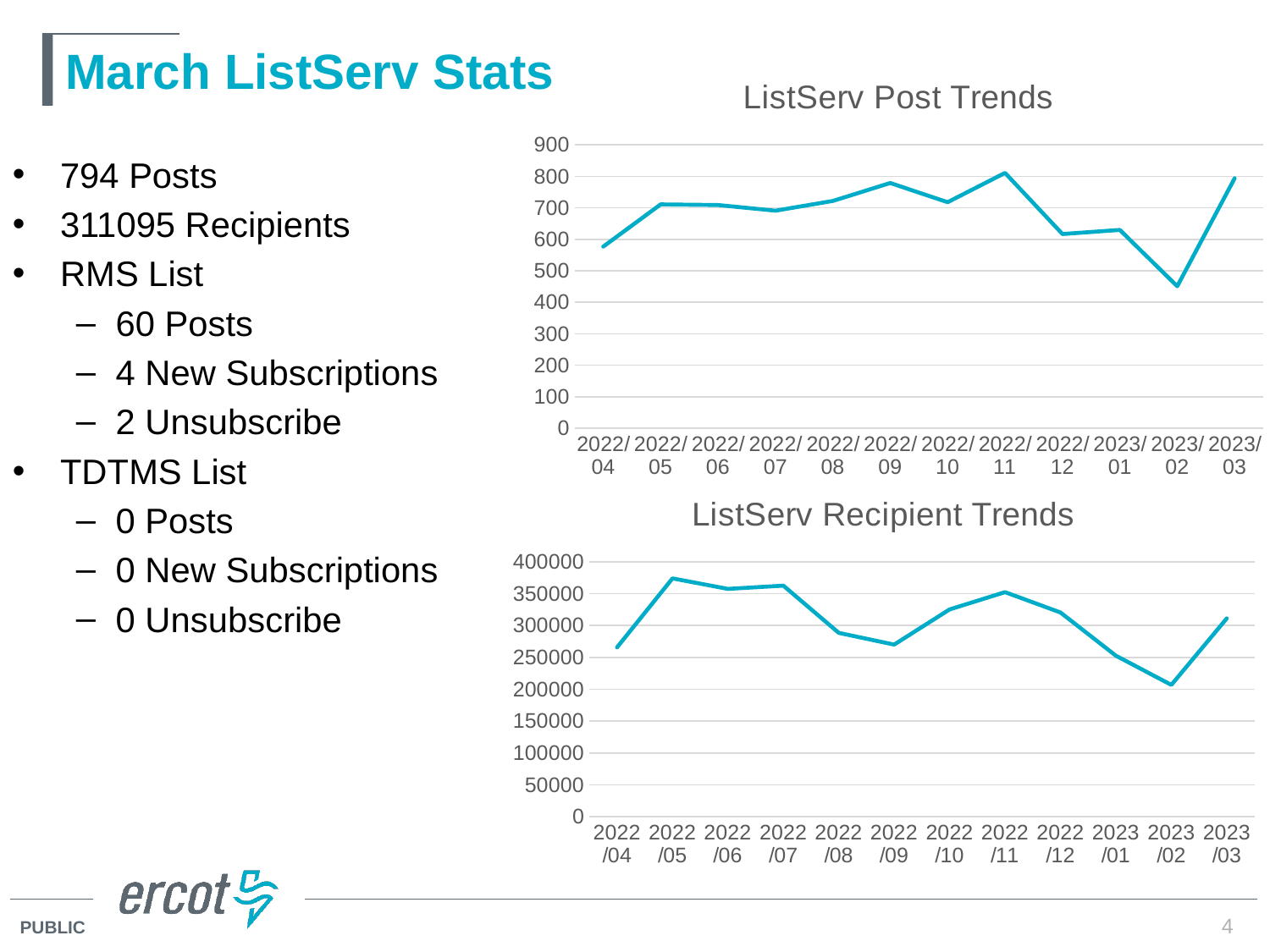
On the "ListServ Post Trends" chart, is the value for 2022/09 greater or less than 700? greater On the "ListServ Recipient Trends" chart, is the value for 2022/05 greater or less than 350000? greater On the "ListServ Post Trends" chart, which month has the lowest value? 2023/02 On the "ListServ Recipient Trends" chart, which is larger, the value for 2022/05 or the value for 2022/09? 2022/05 What kind of chart is the "ListServ Post Trends" chart? line chart On the "ListServ Post Trends" chart, is the value for 2023/02 greater or less than 500? less On the "ListServ Post Trends" chart, which is larger, the value for 2022/11 or the value for 2022/12? 2022/11 On the "ListServ Recipient Trends" chart, which month has the lowest value? 2023/02 How many data points are plotted on the "ListServ Post Trends" chart? 12 What kind of chart is the "ListServ Recipient Trends" chart? line chart